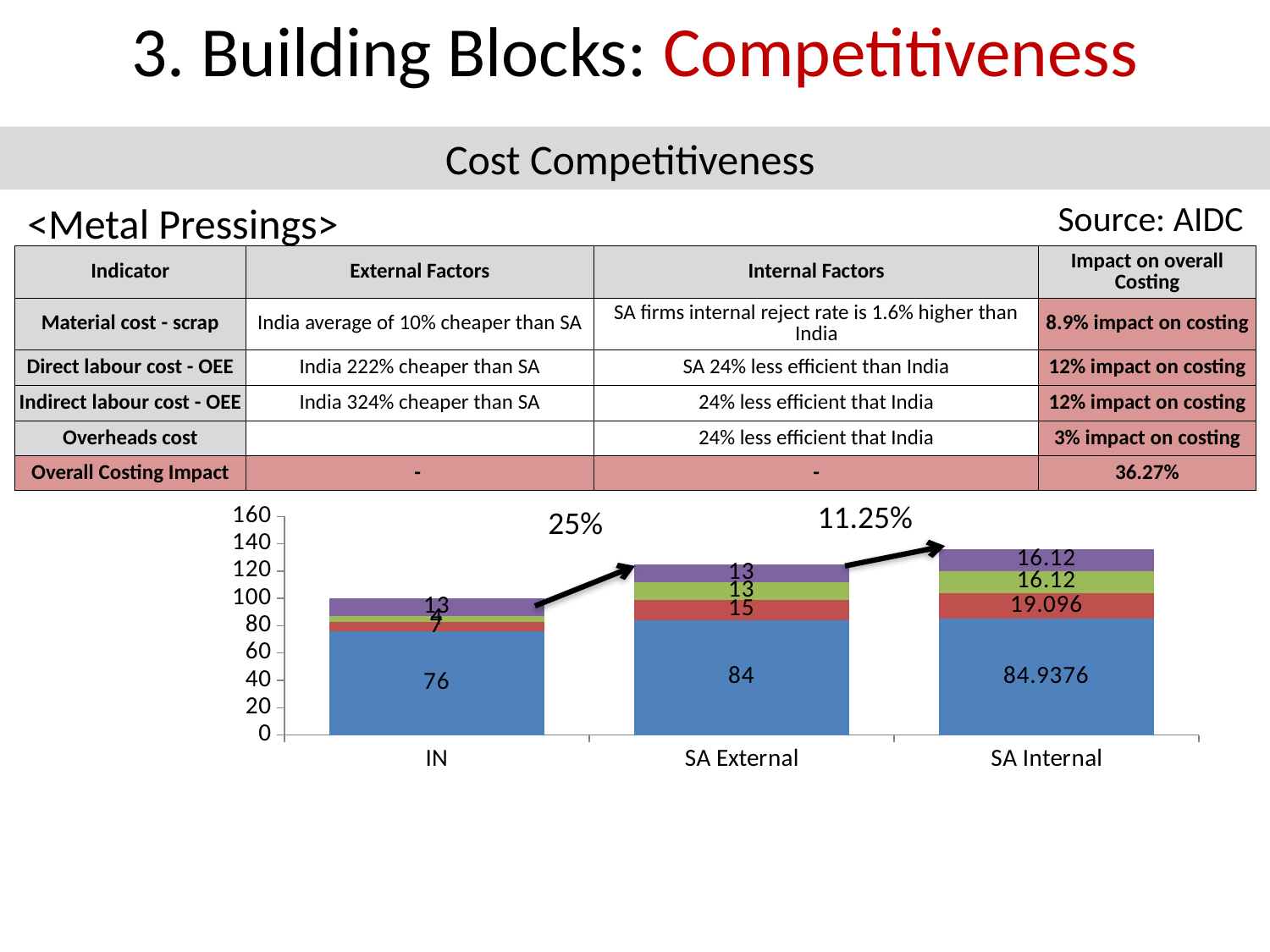
How many categories are shown on the x axis of the chart? 3 What is the total of the SA External stacked bar? 125 What is the value of the top (purple) segment of the SA External bar? 13 What is the value of the bottom (blue) segment of the SA Internal bar? 84.9376 Is the total height of the IN bar greater or less than 120? less What is the difference between the bottom (blue) segment values of SA External and IN? 8 What is the value of the bottom (blue) segment of the SA External bar? 84 Which category has the shortest stacked bar? IN Which category has the tallest stacked bar? SA Internal What is the value of the bottom (blue) segment of the IN bar? 76 What kind of chart is shown on the slide? stacked bar chart What is the value of the red segment of the SA Internal bar? 19.096